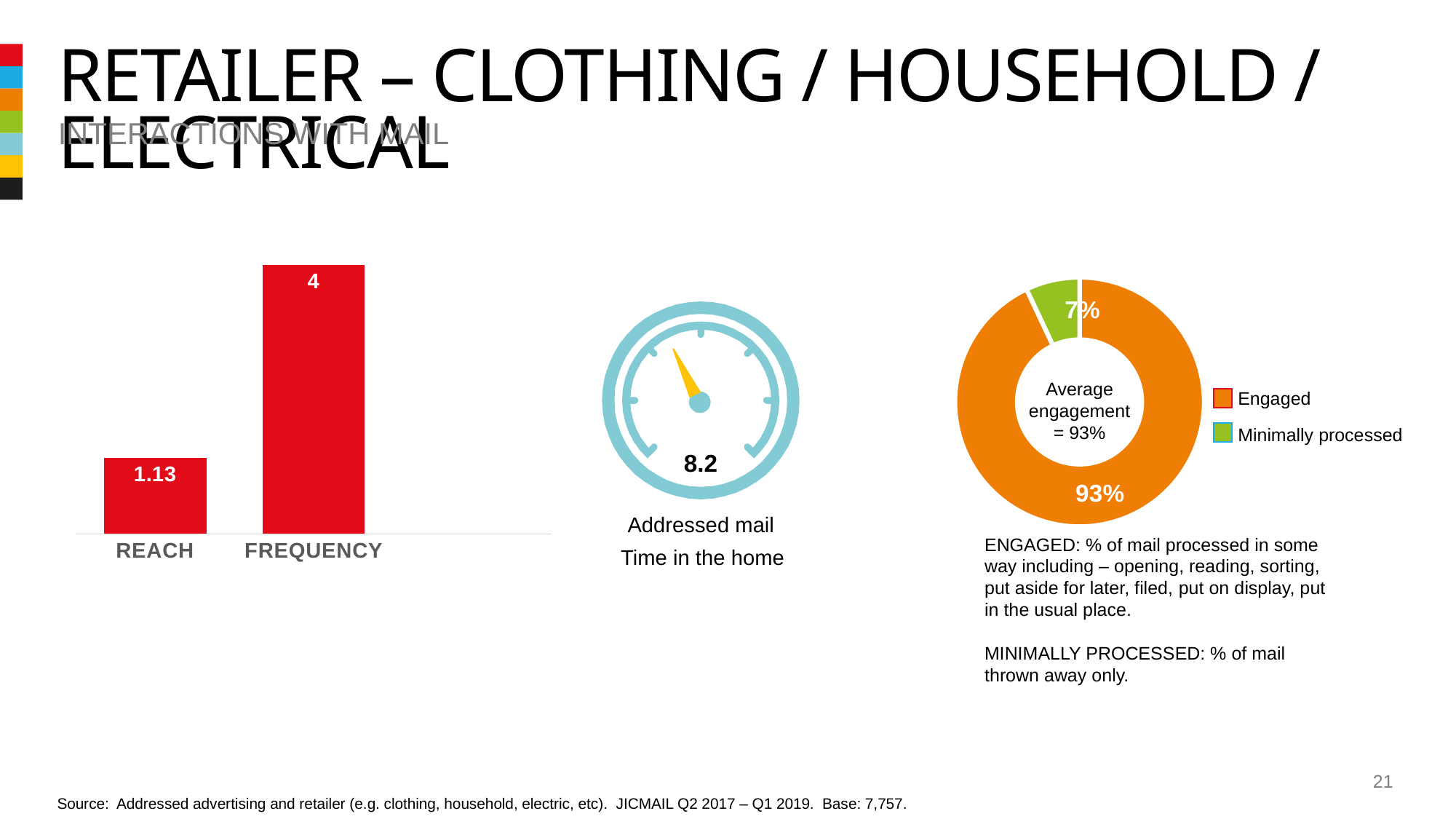
In the donut chart on the right, what share is labelled Minimally processed? 7% In the donut chart on the right, what share is labelled Engaged? 93% How many entries does the legend of the donut chart on the right list? 2 In the bar chart on the left, what is the value for REACH? 1.13 What value is shown on the gauge in the middle of the slide for addressed mail time in the home? 8.2 How many categories are shown in the bar chart on the left? 2 In the bar chart on the left, which category has the higher value? FREQUENCY In the bar chart on the left, which category has the lower value? REACH In the bar chart on the left, what is the value for FREQUENCY? 4 In the bar chart on the left, what is the difference between the FREQUENCY and REACH values? 2.87 In the donut chart on the right, which slice is larger, Engaged or Minimally processed? Engaged What kind of chart is shown on the left of the slide? Bar chart